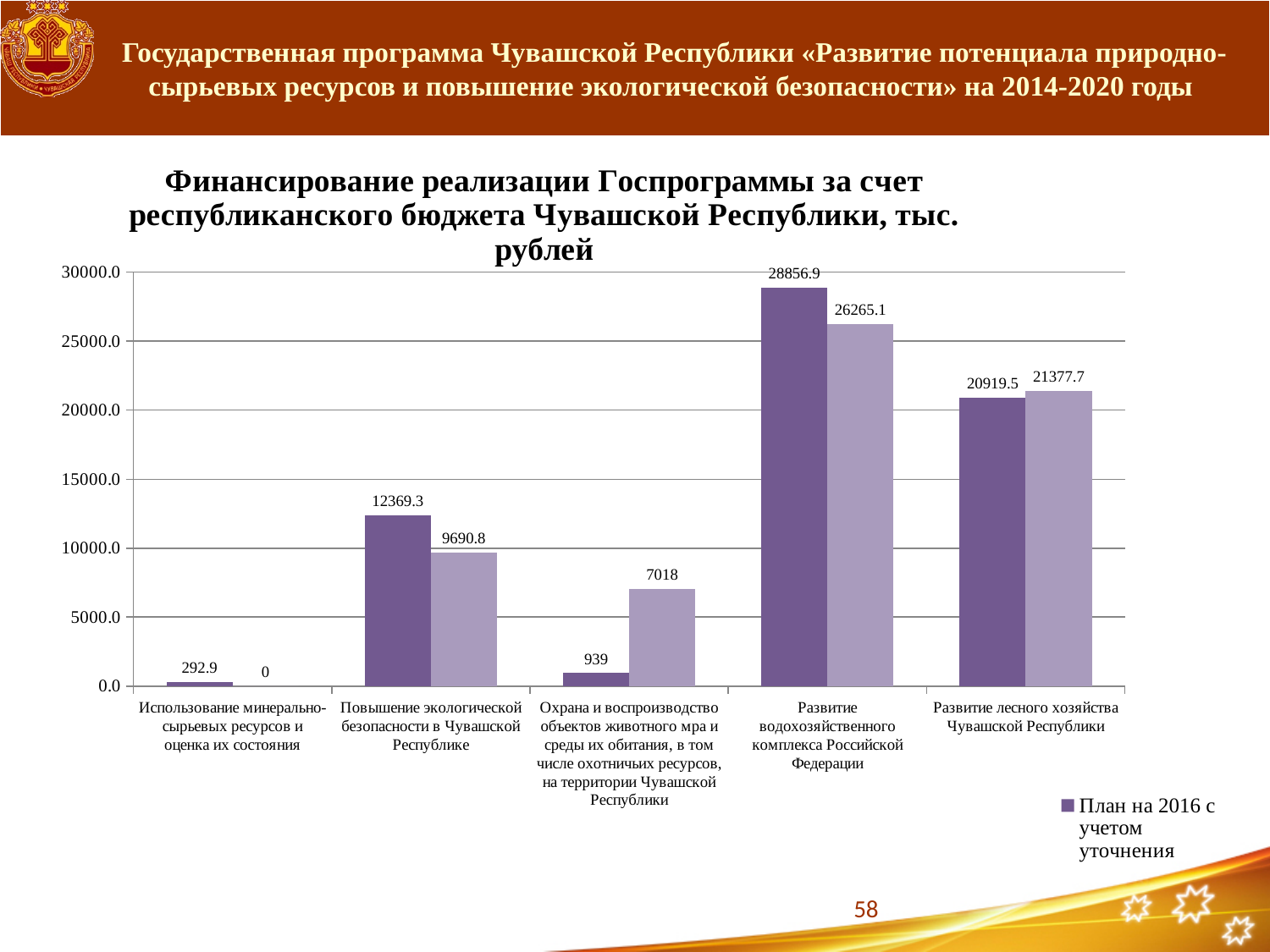
What kind of chart is shown on the slide? bar chart Which category has the highest value for «План на 2016 с учетом уточнения»? Развитие водохозяйственного комплекса Российской Федерации What is the value of «План на 2016 с учетом уточнения» for «Повышение экологической безопасности в Чувашской Республике»? 12369.3 What is the value of «План на 2016 с учетом уточнения» for «Охрана и воспроизводство объектов животного мира и среды их обитания...»? 939 What is the value of «План на 2016 с учетом уточнения» for «Развитие лесного хозяйства Чувашской Республики»? 20919.5 What is the difference between the «План на 2016 с учетом уточнения» values for «Развитие водохозяйственного комплекса Российской Федерации» and «Развитие лесного хозяйства Чувашской Республики»? 7937.4 Which is larger for «План на 2016 с учетом уточнения»: «Повышение экологической безопасности в Чувашской Республике» or «Охрана и воспроизводство объектов животного мира...»? Повышение экологической безопасности в Чувашской Республике Is the «План на 2016 с учетом уточнения» value for «Развитие лесного хозяйства Чувашской Республики» greater or less than 20000.0? greater How many categories are shown on the x axis of the chart? 5 Which category has the lowest value for «План на 2016 с учетом уточнения»? Использование минерально-сырьевых ресурсов и оценка их состояния What is the value of «План на 2016 с учетом уточнения» for «Развитие водохозяйственного комплекса Российской Федерации»? 28856.9 What is the title of the chart? Финансирование реализации Госпрограммы за счет республиканского бюджета Чувашской Республики, тыс. рублей